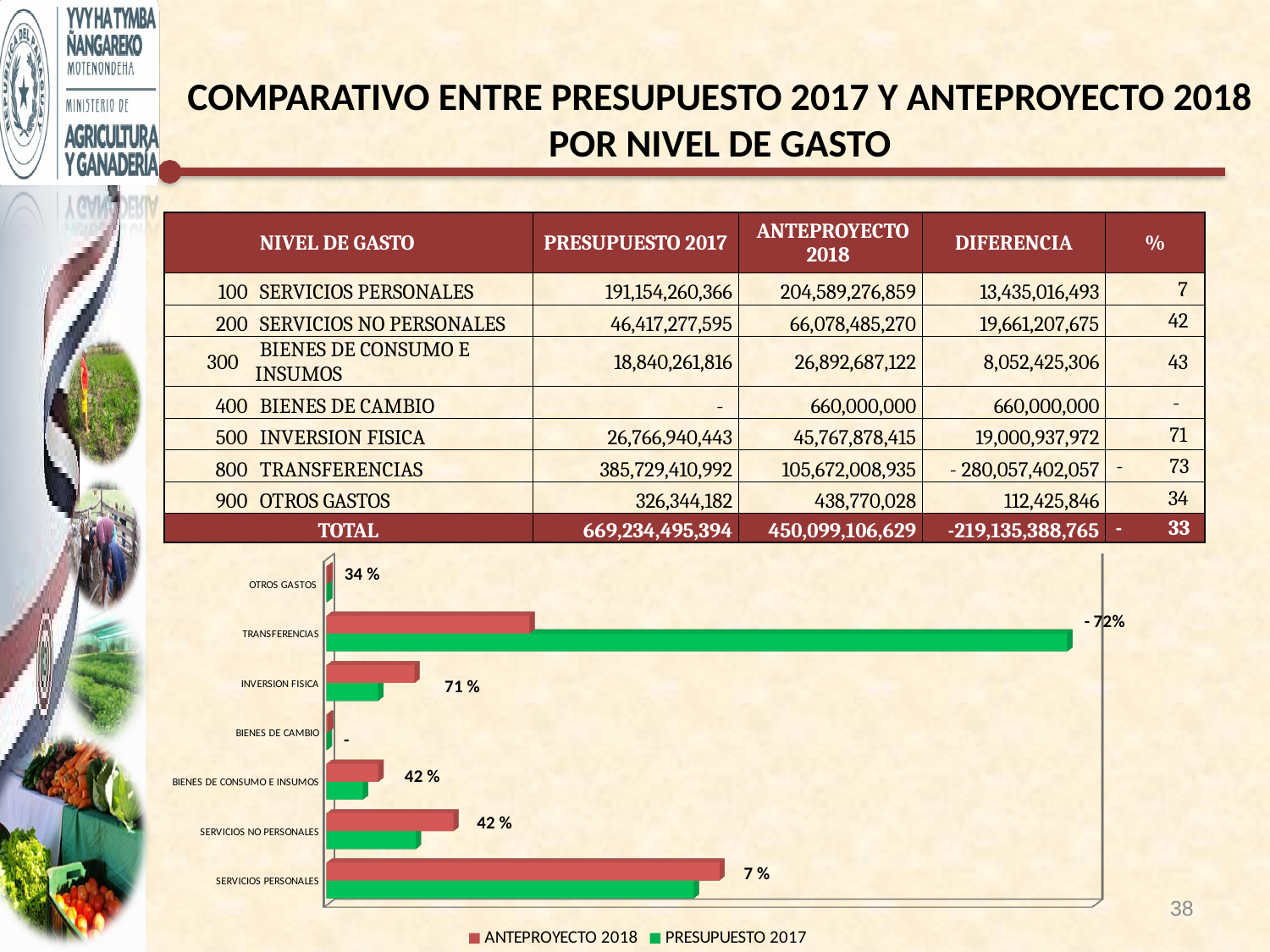
Which series in the bar chart is shown in green? PRESUPUESTO 2017 What percentage label is shown next to the INVERSION FISICA bars in the chart? 71 % In the bar chart, for TRANSFERENCIAS, which series has the longer bar: ANTEPROYECTO 2018 or PRESUPUESTO 2017? PRESUPUESTO 2017 What percentage label is shown next to the TRANSFERENCIAS bars in the chart? - 72% How many series does the legend of the bar chart list? 2 What kind of chart is shown at the bottom of the slide? bar chart What percentage label is shown next to the OTROS GASTOS bars in the chart? 34 % In the bar chart, which category has the longest bar overall? TRANSFERENCIAS In the bar chart, for INVERSION FISICA, which series has the longer bar: ANTEPROYECTO 2018 or PRESUPUESTO 2017? ANTEPROYECTO 2018 Which series in the bar chart is shown in red? ANTEPROYECTO 2018 What percentage label is shown next to the SERVICIOS PERSONALES bars in the chart? 7 % How many categories does the bar chart show? 7